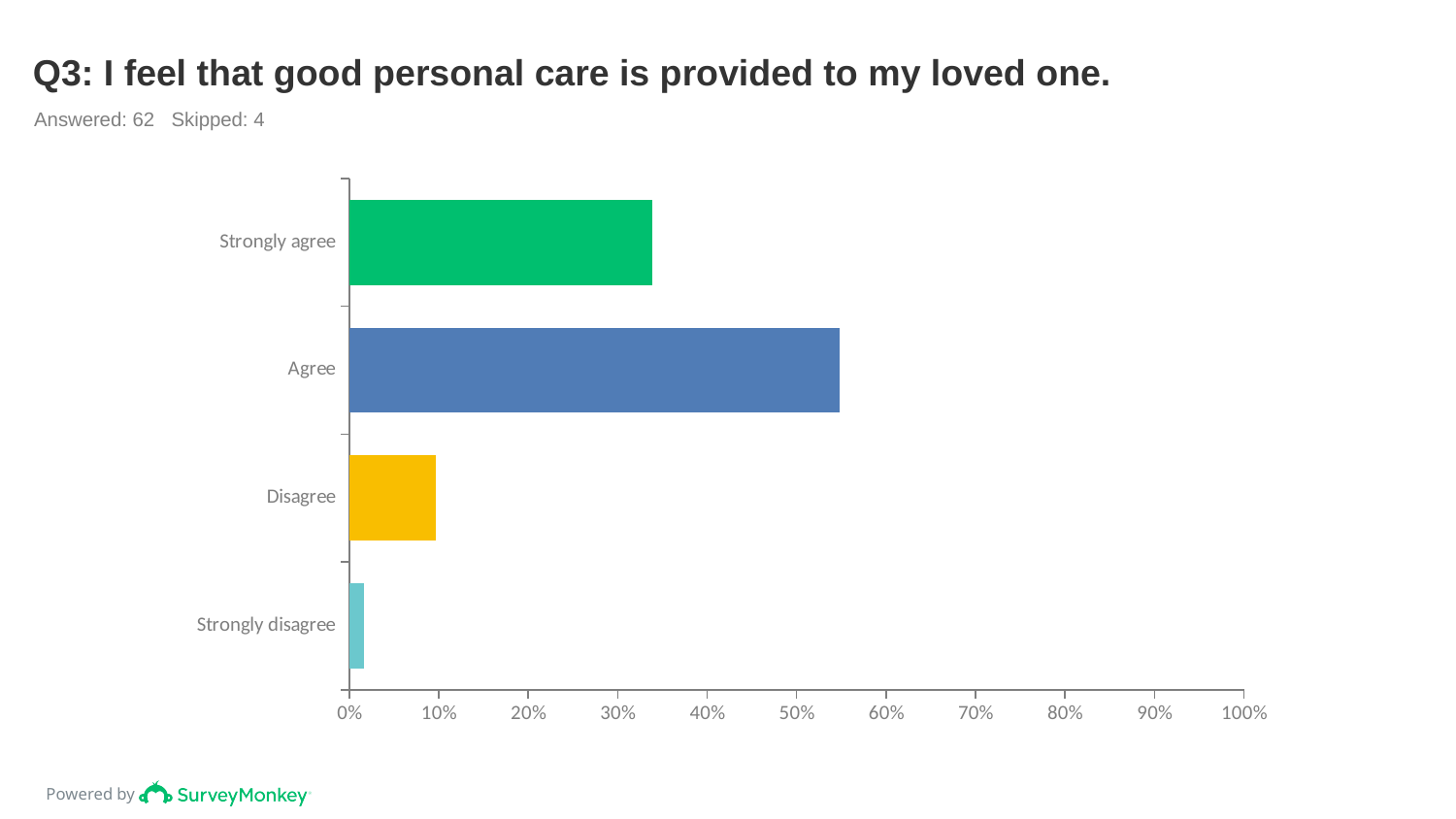
Is the value for Strongly agree greater or less than 30%? greater What kind of chart is shown on the slide? bar chart Is the value for Agree greater or less than 50%? greater Which response category has the lowest value? Strongly disagree Which is larger, the value for Disagree or the value for Strongly disagree? Disagree How many response categories are shown in the chart? 4 What is the maximum value shown on the horizontal axis? 100% How many respondents answered the question, according to the slide? 62 Is the value for Strongly agree greater or less than 40%? less Which response category has the highest value? Agree Which is larger, the value for Strongly agree or the value for Agree? Agree